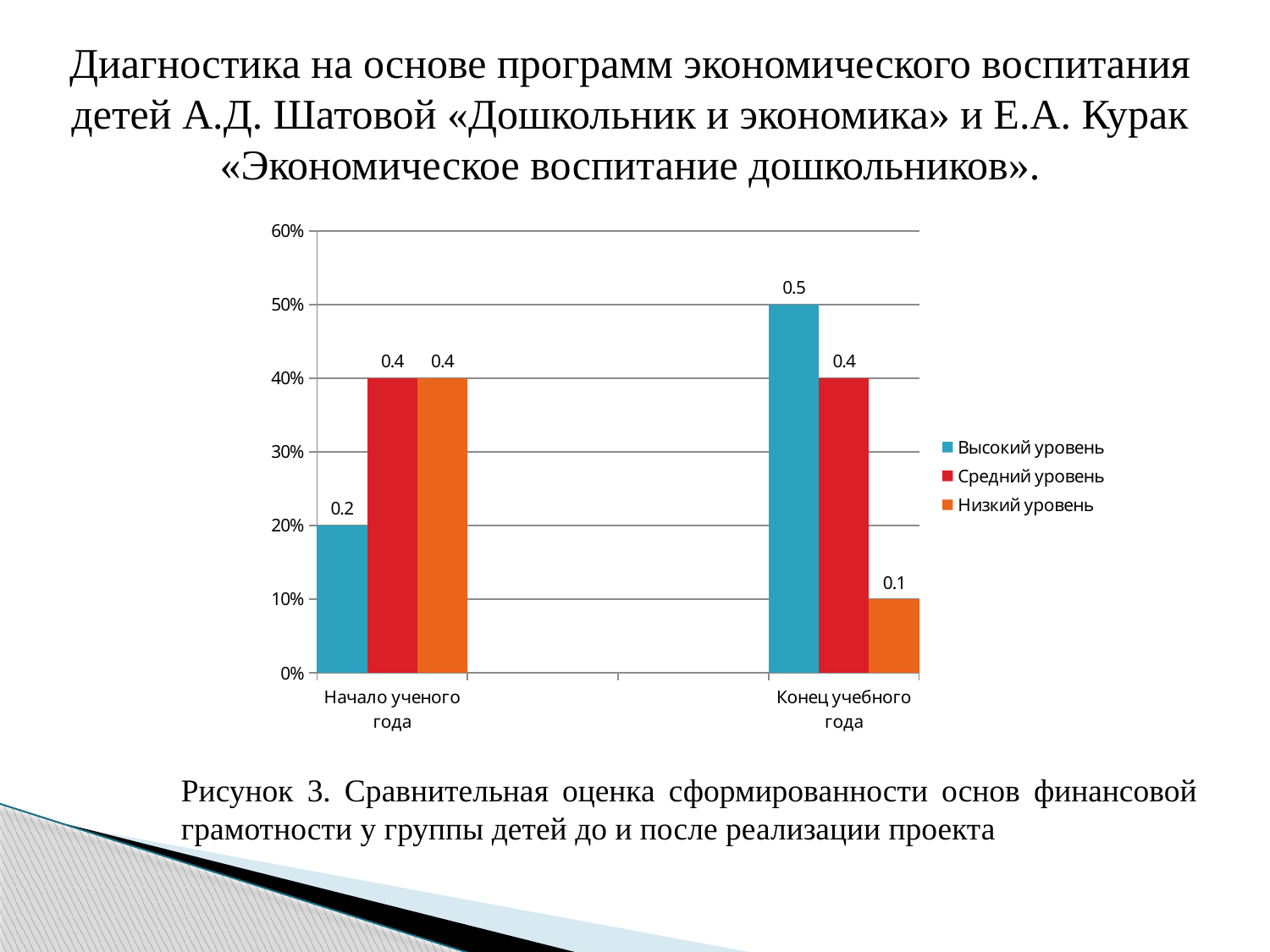
What is the difference between the Высокий уровень values at Конец учебного года and Начало ученого года? 0.3 How many categories are shown on the x axis? 2 Which series has the highest value at Конец учебного года? Высокий уровень Does the value for Высокий уровень rise or fall from Начало ученого года to Конец учебного года? rise How many series does the legend list? 3 Which is larger: Низкий уровень at Начало ученого года or Низкий уровень at Конец учебного года? Начало ученого года Which series has the lowest value at Начало ученого года? Высокий уровень What is the value for Средний уровень at Начало ученого года? 0.4 What kind of chart is shown on the slide? bar chart What is the value for Высокий уровень at Начало ученого года? 0.2 What is the value for Низкий уровень at Конец учебного года? 0.1 What is the value for Высокий уровень at Конец учебного года? 0.5